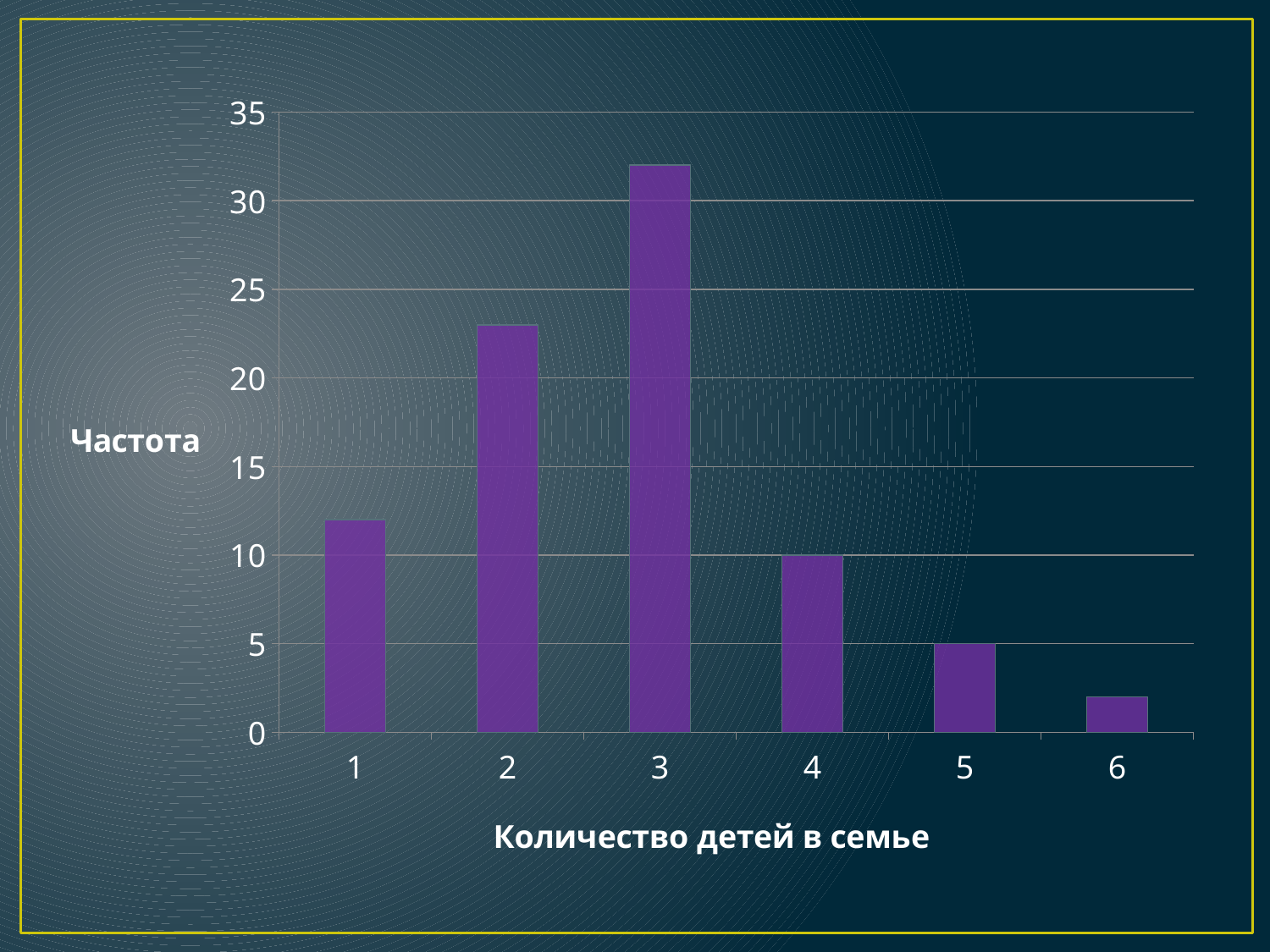
What is the frequency for families with 5 children? 5 Which has a higher frequency: families with 2 children or families with 4 children? 2 children What is the difference between the frequencies for families with 4 children and families with 5 children? 5 What is the frequency for families with 4 children? 10 Is the frequency for families with 1 child greater or less than 10? greater Is the frequency for families with 3 children greater or less than 30? greater What is the label of the x axis? Количество детей в семье Which number of children in a family has the lowest frequency? 6 What kind of chart is shown on the slide? bar chart How many categories are shown on the x axis? 6 Is the frequency for families with 2 children greater or less than 25? less Which number of children in a family has the highest frequency? 3